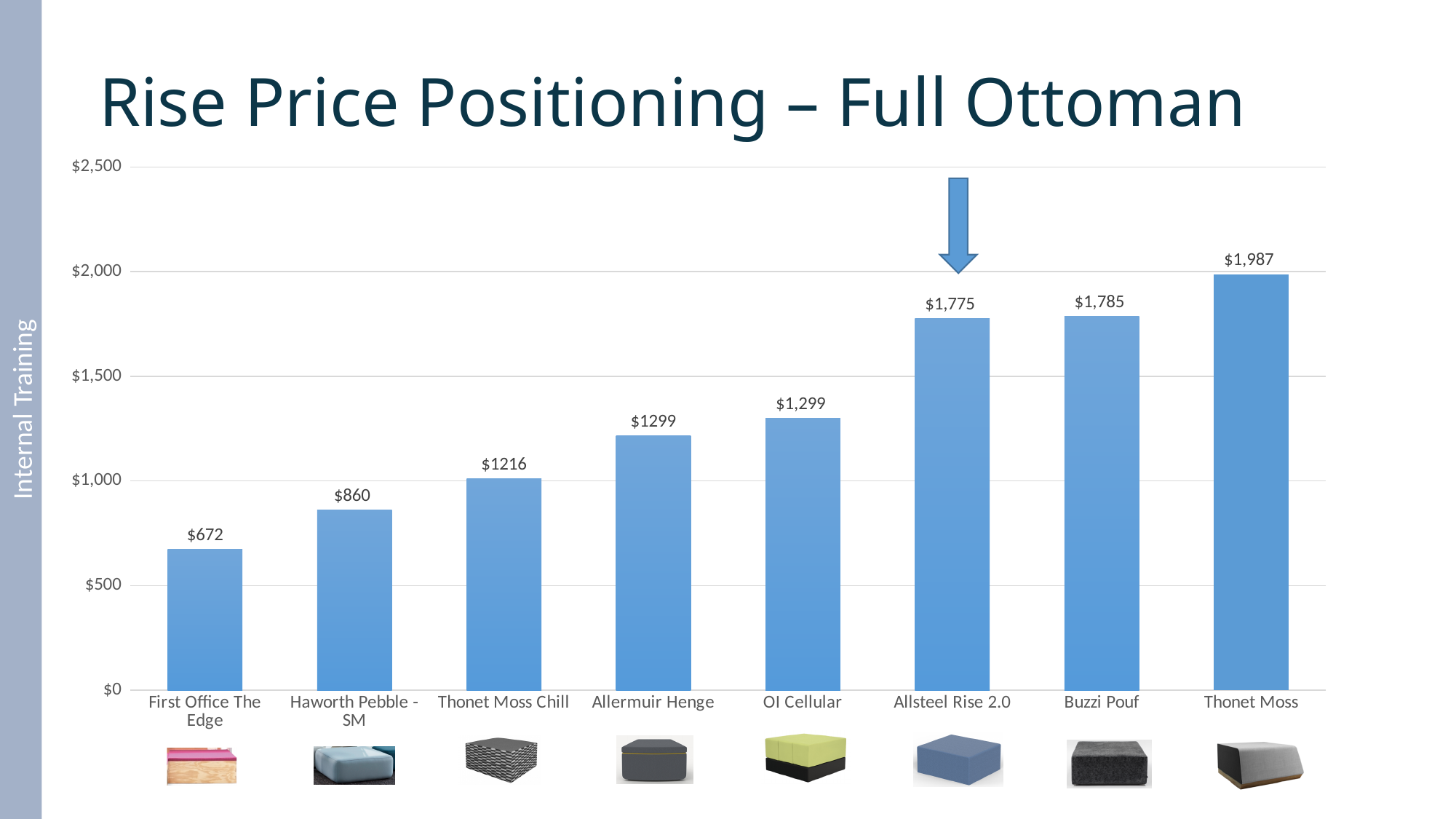
Is the value for Thonet Moss greater or less than $1,500? greater What is the price shown for Allsteel Rise 2.0? $1,775 What is the price shown for Haworth Pebble - SM? $860 What is the price shown for First Office The Edge? $672 Which is priced higher, OI Cellular or Allsteel Rise 2.0? Allsteel Rise 2.0 Which product does the blue arrow above the chart point to? Allsteel Rise 2.0 What kind of chart is shown on the slide? Bar chart Which product has the lowest price on the chart? First Office The Edge What is the difference in price between Thonet Moss and Allsteel Rise 2.0? $212 What is the price shown for Buzzi Pouf? $1,785 How many products are shown on the chart? 8 Which product has the highest price on the chart? Thonet Moss